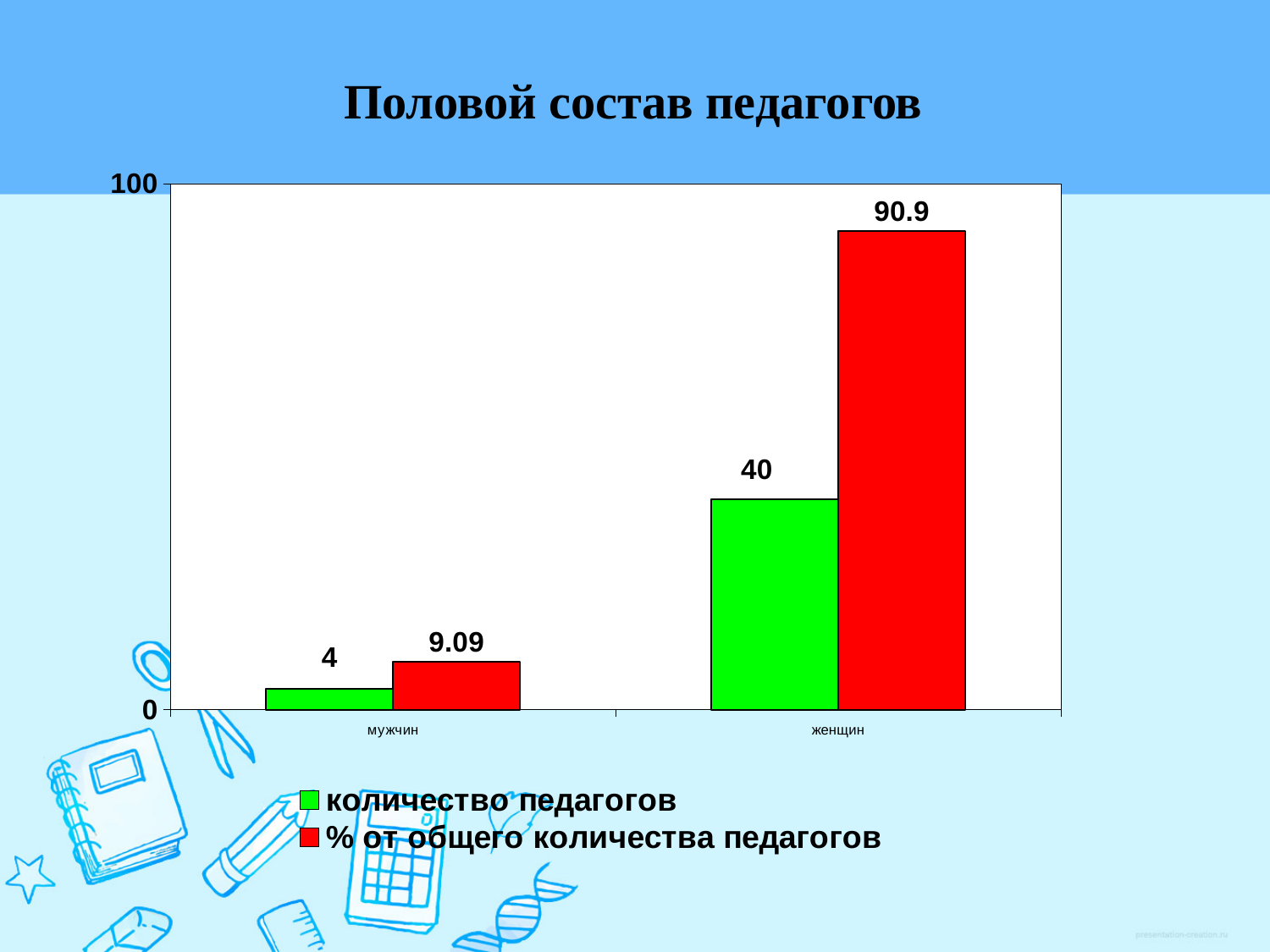
How many categories are shown on the x axis? 2 Which category has the highest value for 'количество педагогов'? женщин What kind of chart is shown on the slide? bar chart Which is larger: the '% от общего количества педагогов' value for 'женщин' or for 'мужчин'? женщин What is the value of 'количество педагогов' for 'женщин'? 40 What is the value of '% от общего количества педагогов' for 'мужчин'? 9.09 How many series does the legend list? 2 What is the value of '% от общего количества педагогов' for 'женщин'? 90.9 What is the title of the chart? Половой состав педагогов Which category has the lowest value for '% от общего количества педагогов'? мужчин What is the value of 'количество педагогов' for 'мужчин'? 4 What is the difference between the 'количество педагогов' values for 'женщин' and 'мужчин'? 36